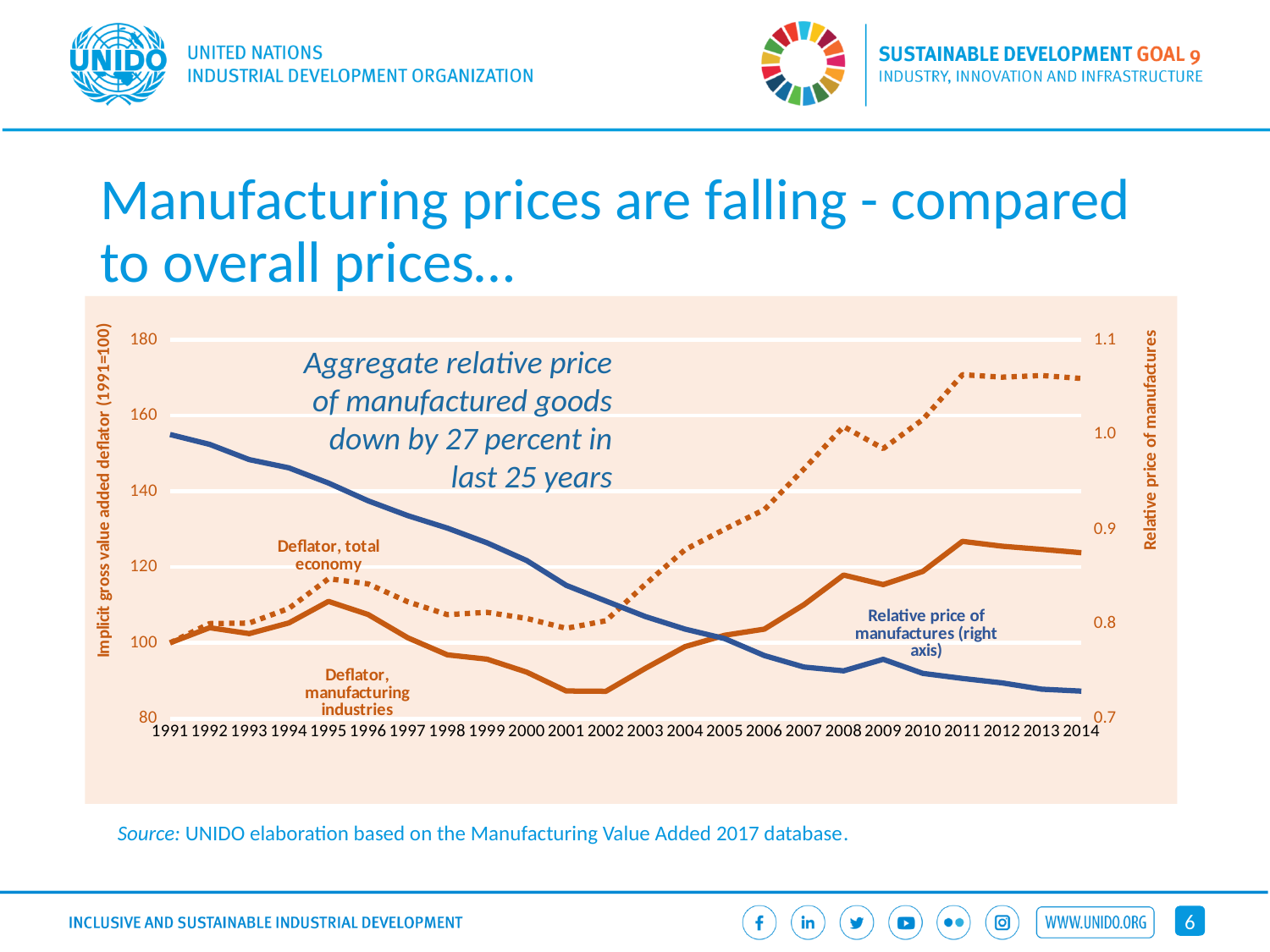
How many series are plotted on the chart? 3 Is the value for 'Deflator, total economy' in 2014 greater or less than 160? greater What is the label of the right-hand vertical axis of the chart? Relative price of manufactures What is the value of the 'Relative price of manufactures (right axis)' series in 1991? 1.0 In which year does the 'Deflator, manufacturing industries' series reach its highest value? 2011 What kind of chart is shown on the slide? line chart How many years are shown along the x axis of the chart? 24 What is the value of the 'Deflator, manufacturing industries' series in 1991? 100 Is the value for 'Relative price of manufactures (right axis)' in 2014 greater or less than 0.8? less Does the 'Relative price of manufactures (right axis)' series generally rise or fall from 1991 to 2014? fall Is the value for 'Deflator, manufacturing industries' in 2002 greater or less than 100? less In 2014, which series is higher: 'Deflator, total economy' or 'Deflator, manufacturing industries'? Deflator, total economy